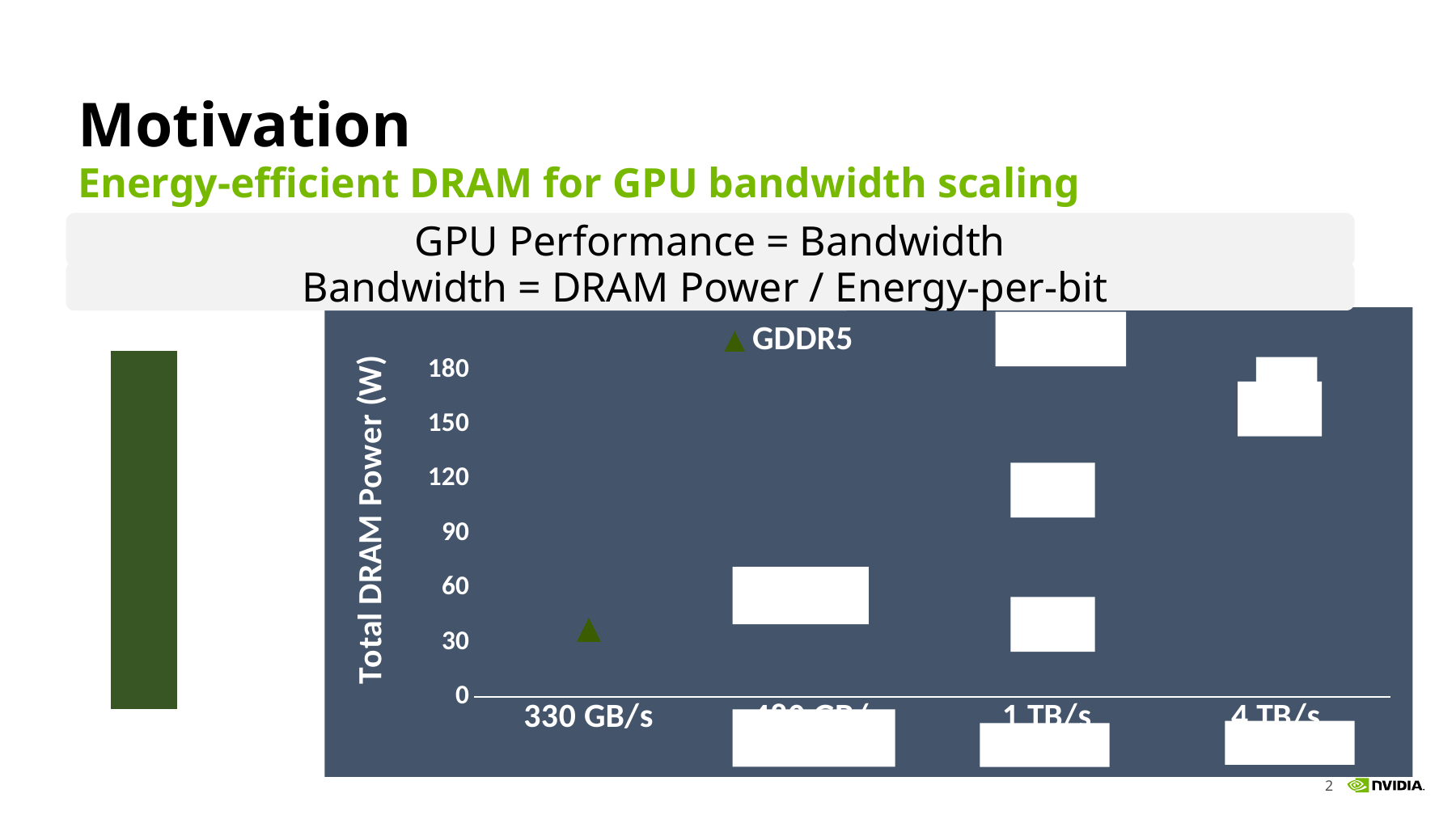
What marker shape is used for the GDDR5 series? triangle Is the GDDR5 value at 330 GB/s greater or less than 90? less What is the first category label on the x-axis? 330 GB/s Is the GDDR5 value at 330 GB/s greater or less than 60? less How many category labels are shown along the x-axis? 4 What is the highest tick value shown on the y-axis? 180 Which series does the chart's legend list? GDDR5 What is the last category label on the x-axis? 4 TB/s What is the y-axis label of the chart? Total DRAM Power (W)